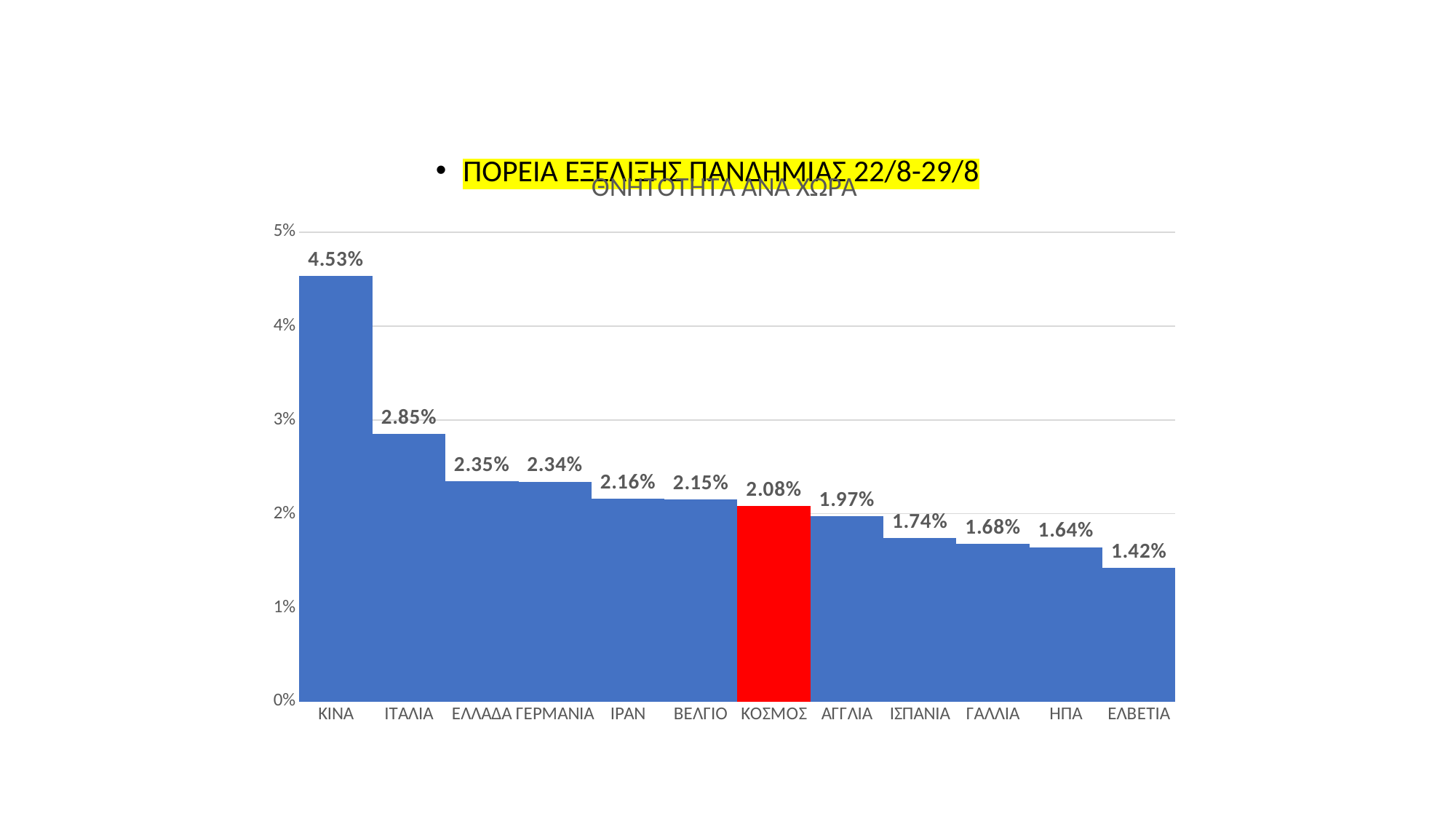
What value is shown for ΕΛΒΕΤΙΑ? 1.42% What value is shown for ΙΣΠΑΝΙΑ? 1.74% How many categories are shown on the x axis? 12 Which bar is coloured red instead of blue? ΚΟΣΜΟΣ What kind of chart is shown on the slide? Bar chart Do the values rise or fall from left to right along the x axis? Fall What value is shown for ΚΟΣΜΟΣ? 2.08% What is the mortality value shown for ΚΙΝΑ? 4.53% What is the difference between the values for ΚΙΝΑ and ΙΤΑΛΙΑ? 1.68 percentage points Which has a larger value, ΙΤΑΛΙΑ or ΑΓΓΛΙΑ? ΙΤΑΛΙΑ Which country has the highest value in the chart? ΚΙΝΑ Which category has the lowest value in the chart? ΕΛΒΕΤΙΑ